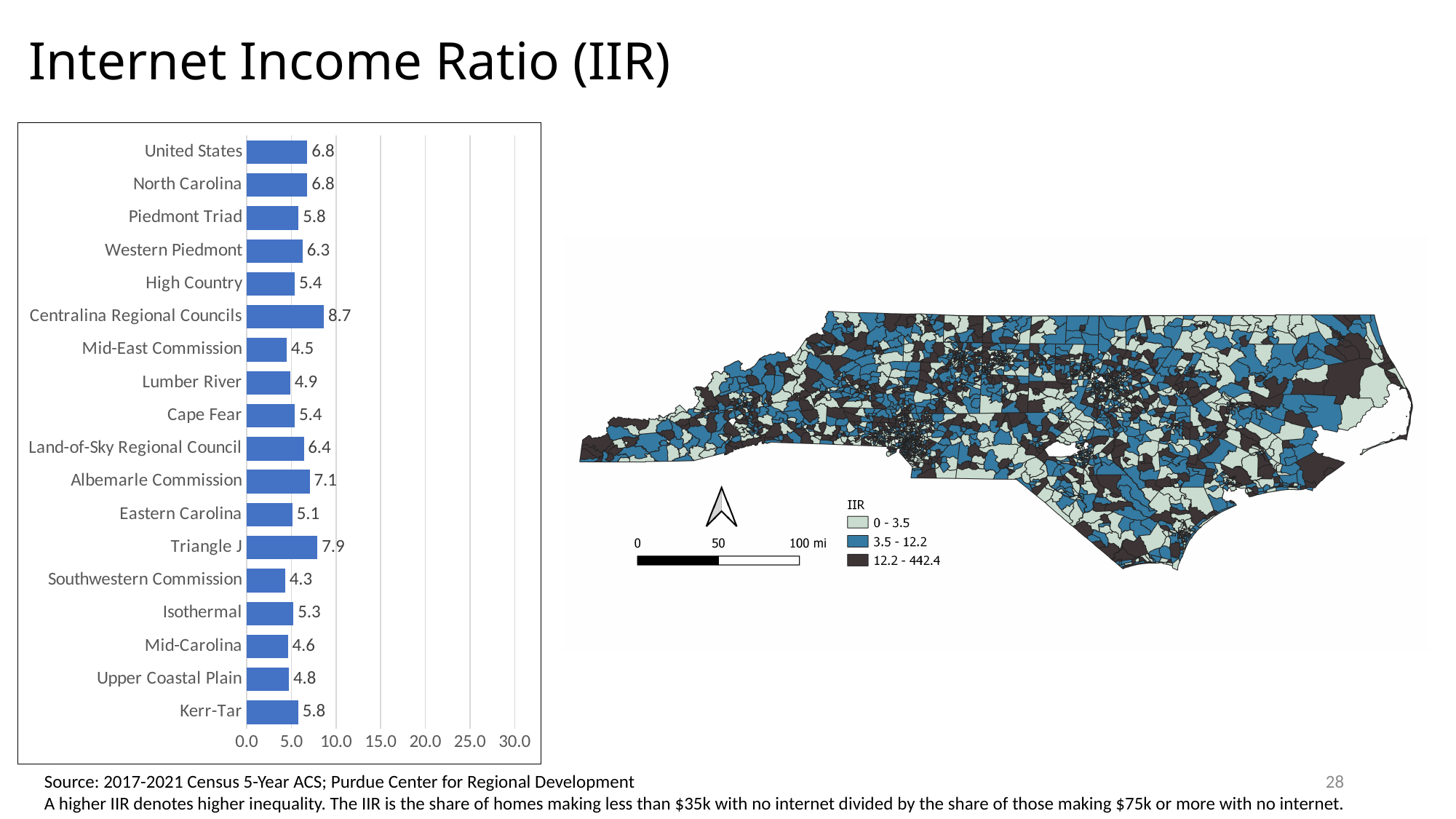
What is the IIR value for Triangle J in the bar chart? 7.9 What is the IIR value for North Carolina in the bar chart? 6.8 What type of chart is shown on the left side of the slide? Bar chart In the bar chart, is the IIR value for Kerr-Tar greater or less than 5.0? greater In the bar chart, what is the difference between the IIR values for Albemarle Commission and Mid-East Commission? 2.6 Which region has the lowest IIR value in the bar chart? Southwestern Commission In the bar chart, what is the difference between the IIR values for Centralina Regional Councils and Southwestern Commission? 4.4 In the bar chart, which has a higher IIR value, Triangle J or Western Piedmont? Triangle J Which region has the highest IIR value in the bar chart? Centralina Regional Councils What is the IIR value for Upper Coastal Plain in the bar chart? 4.8 What is the IIR value for Centralina Regional Councils in the bar chart? 8.7 How many categories (bars) are shown in the bar chart? 18